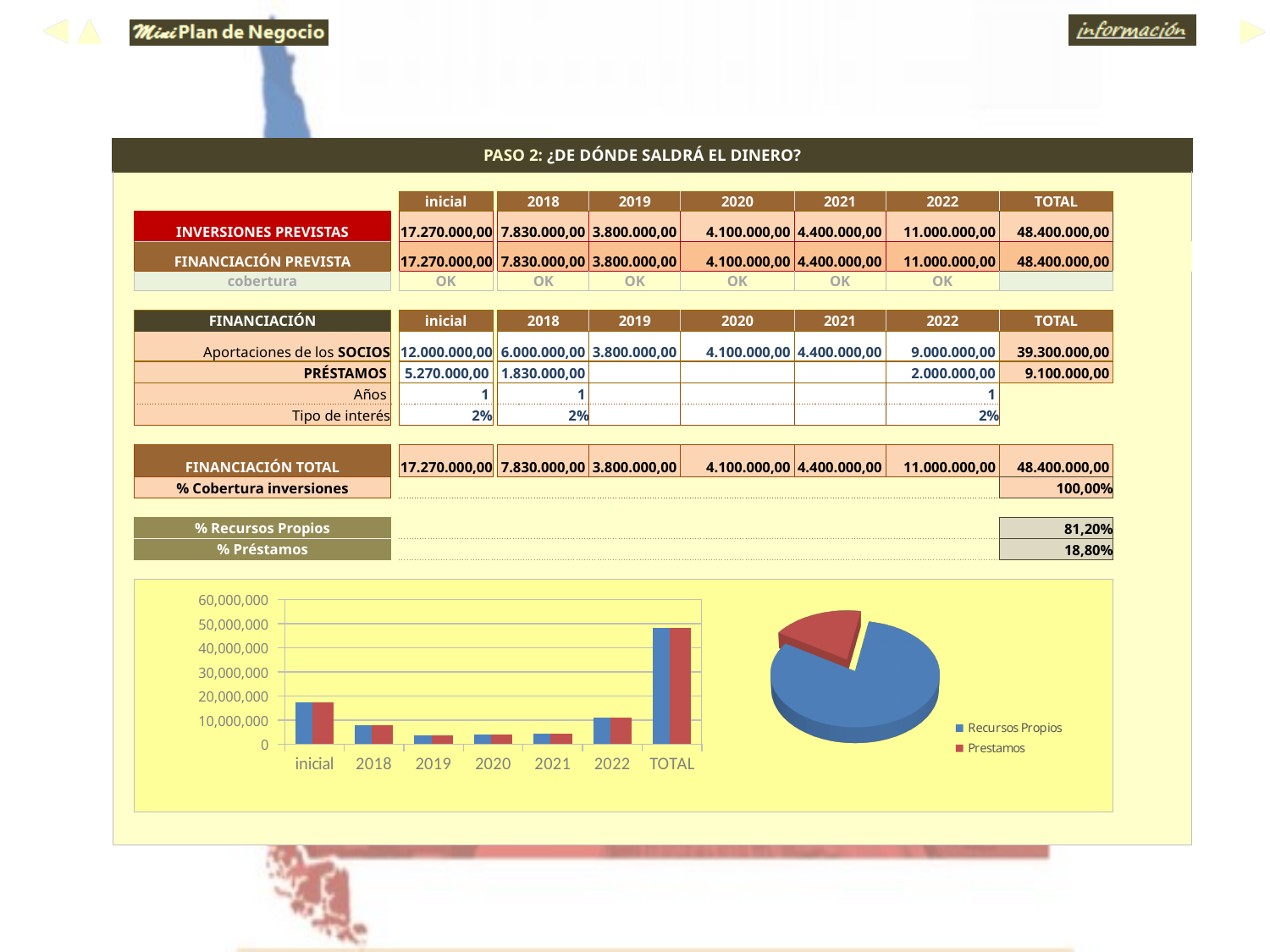
In the bar chart on the left, which category has the tallest bars? TOTAL In the bar chart on the left, how many categories are shown on the x axis? 7 How many entries does the legend of the pie chart on the right list? 2 In the bar chart on the left, are the bars for inicial taller or shorter than the bars for 2018? taller In the bar chart on the left, is the value for TOTAL greater or less than 40,000,000? greater In the pie chart on the right, what colour is the Prestamos slice? red What kind of chart is the chart on the left of the slide? bar chart In the bar chart on the left, do the values rise or fall from inicial to 2019? fall What kind of chart is the chart on the right of the slide? pie chart In the bar chart on the left, is the value for 2018 greater or less than 10,000,000? less In the bar chart on the left, is the value for inicial greater or less than 10,000,000? greater In the pie chart on the right, which slice is larger, Recursos Propios or Prestamos? Recursos Propios